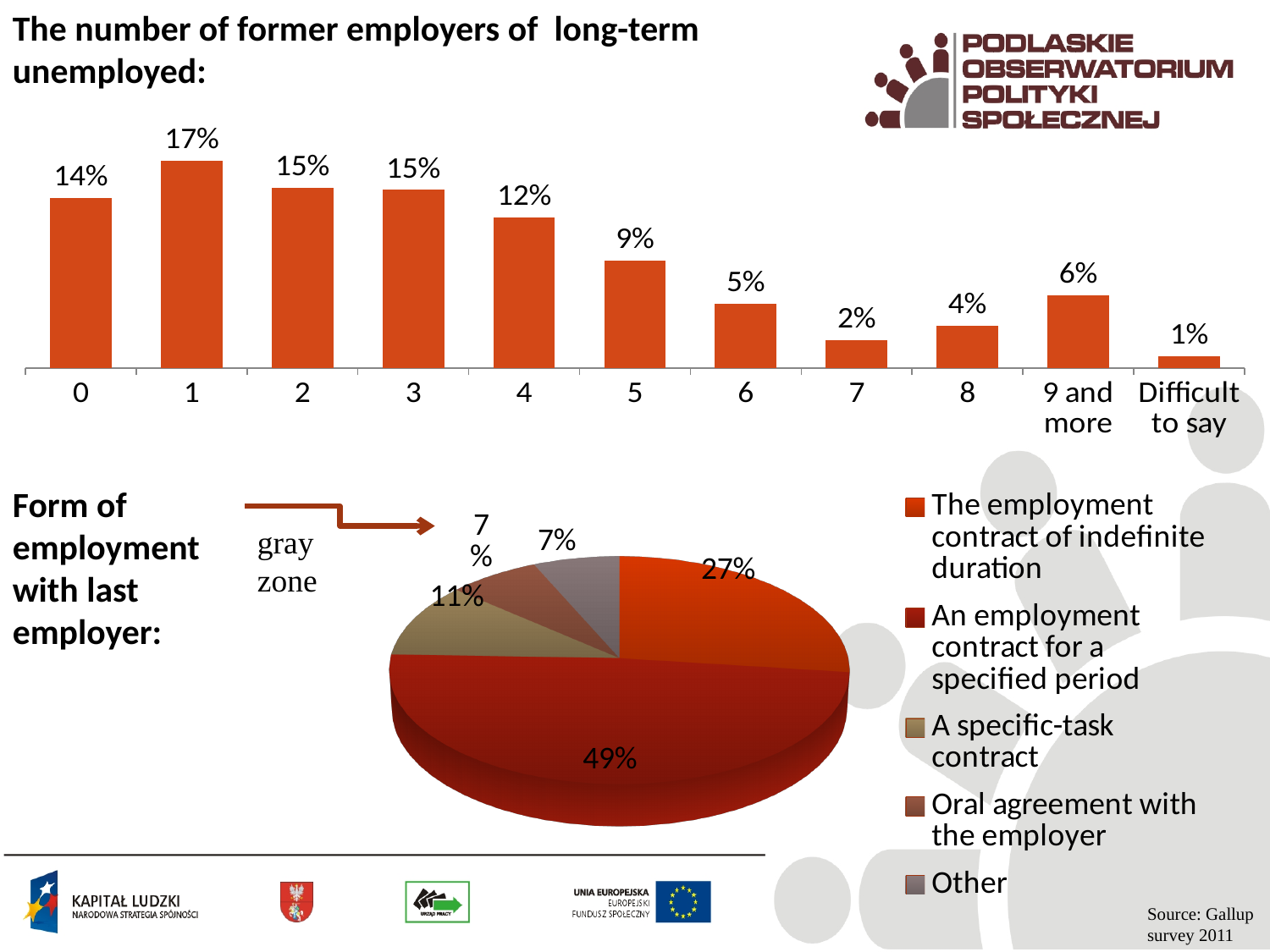
In the bar chart on the number of former employers, which category has the highest value? 1 How many categories are shown on the x axis of the bar chart on the number of former employers? 11 How many entries does the legend of the pie chart on form of employment with last employer list? 5 In the bar chart on the number of former employers, which is larger: the value for 5 or the value for 6 former employers? 5 In the bar chart on the number of former employers, what is the value for the '9 and more' category? 6% In the pie chart on form of employment with last employer, what share is 'An employment contract for a specified period'? 49% In the bar chart on the number of former employers, what is the difference between the values for 0 and 4 former employers? 2% In the pie chart on form of employment with last employer, what share is 'The employment contract of indefinite duration'? 27% What type of chart is used for the number of former employers of long-term unemployed? Bar chart In the bar chart on the number of former employers, what percentage of long-term unemployed had 1 former employer? 17% In the bar chart on the number of former employers, which category has the lowest value? Difficult to say What type of chart shows the form of employment with last employer? Pie chart